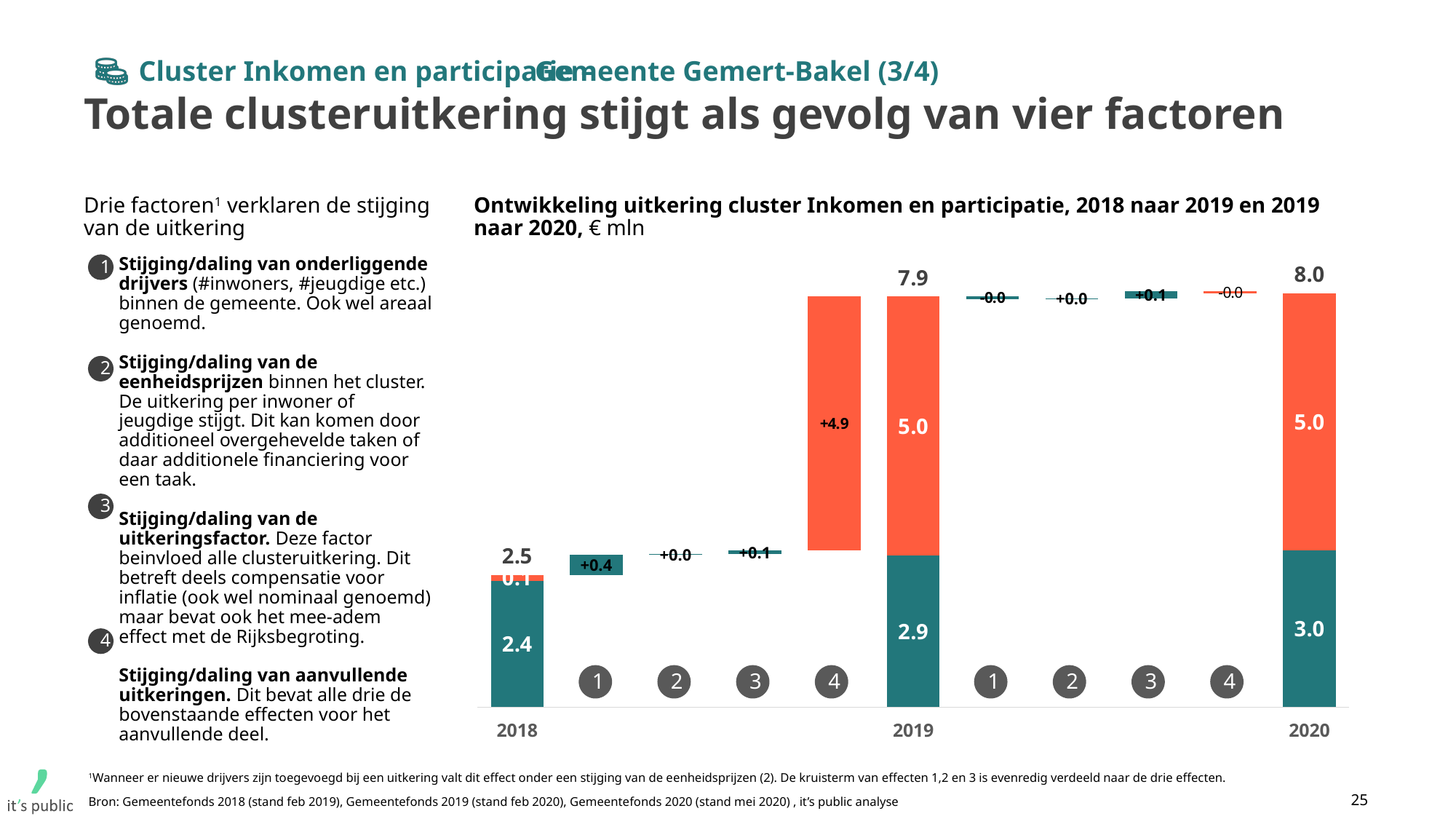
What is the value of the step labelled 1 between 2018 and 2019? +0.4 What is the value of the teal (lower) segment of the 2020 bar? 3.0 What is the value of the orange (upper) segment of the 2019 bar? 5.0 Do the year totals rise or fall from 2018 to 2020? rise What is the value of the step labelled 4 between 2018 and 2019? +4.9 What is the total uitkering for 2019 shown on the chart? 7.9 What unit is the chart expressed in, according to its title? € mln What is the total uitkering for 2020 shown on the chart? 8.0 Which year has the highest total uitkering? 2020 What is the difference between the 2019 total and the 2018 total? 5.4 Which year has the lowest total uitkering? 2018 What is the total uitkering for 2018 shown on the chart? 2.5